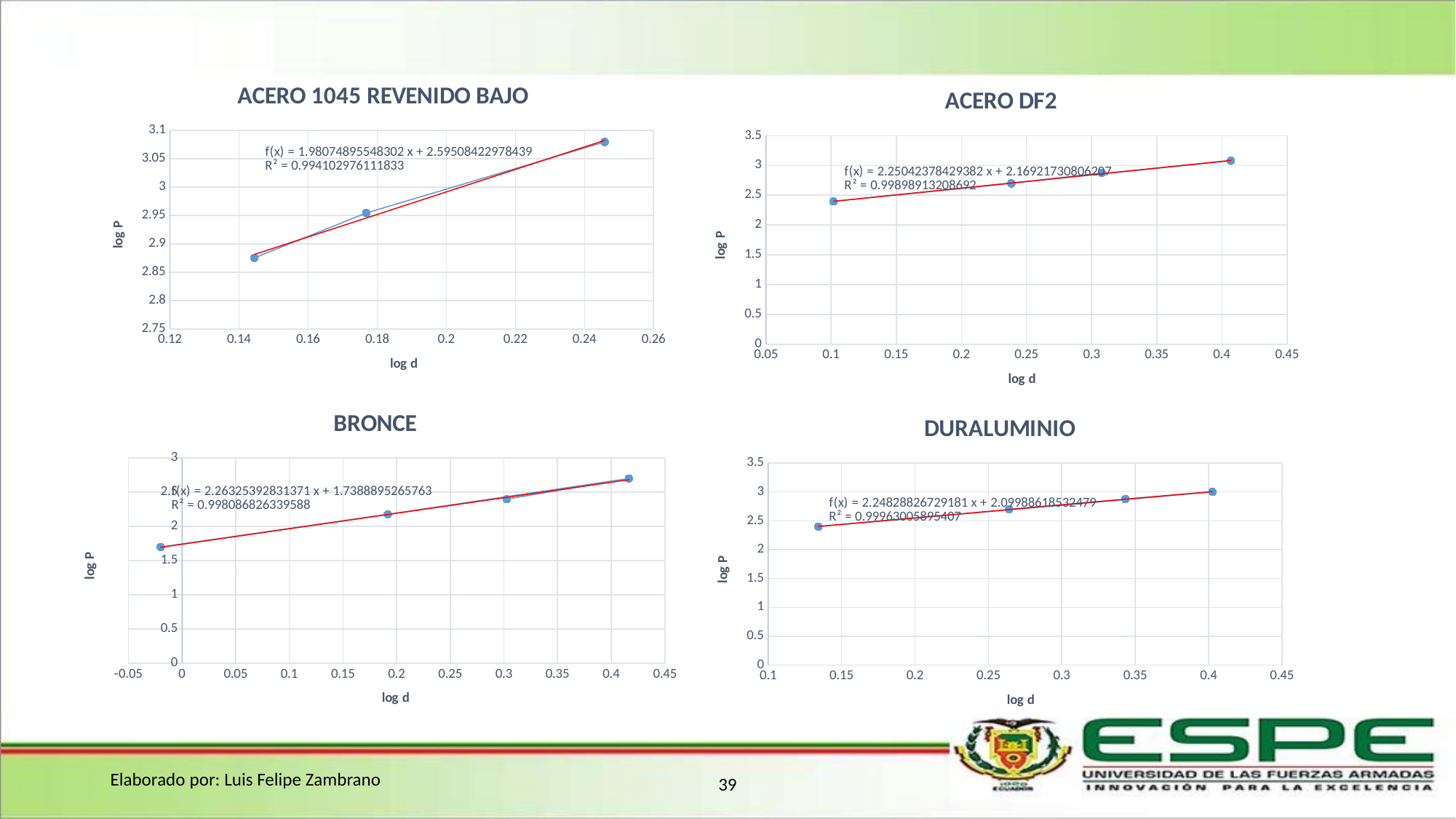
In the ACERO DF2 chart, is the log P value of the leftmost point greater or less than 2? greater In the BRONCE chart, is the log P value of the rightmost point greater or less than 2.5? greater What is the R² value shown in the DURALUMINIO chart? 0.99963005895407 How many data points are plotted in the DURALUMINIO chart? 4 In the BRONCE chart, do the values of log P rise or fall as log d increases? rise What is the label of the x axis in the BRONCE chart? log d How many data points are plotted in the ACERO DF2 chart? 4 What type of chart is the ACERO 1045 REVENIDO BAJO chart? scatter chart What is the R² value shown in the ACERO 1045 REVENIDO BAJO chart? 0.994102976111833 In the DURALUMINIO chart, do the values of log P rise or fall along the x axis? rise How many data points are plotted in the BRONCE chart? 4